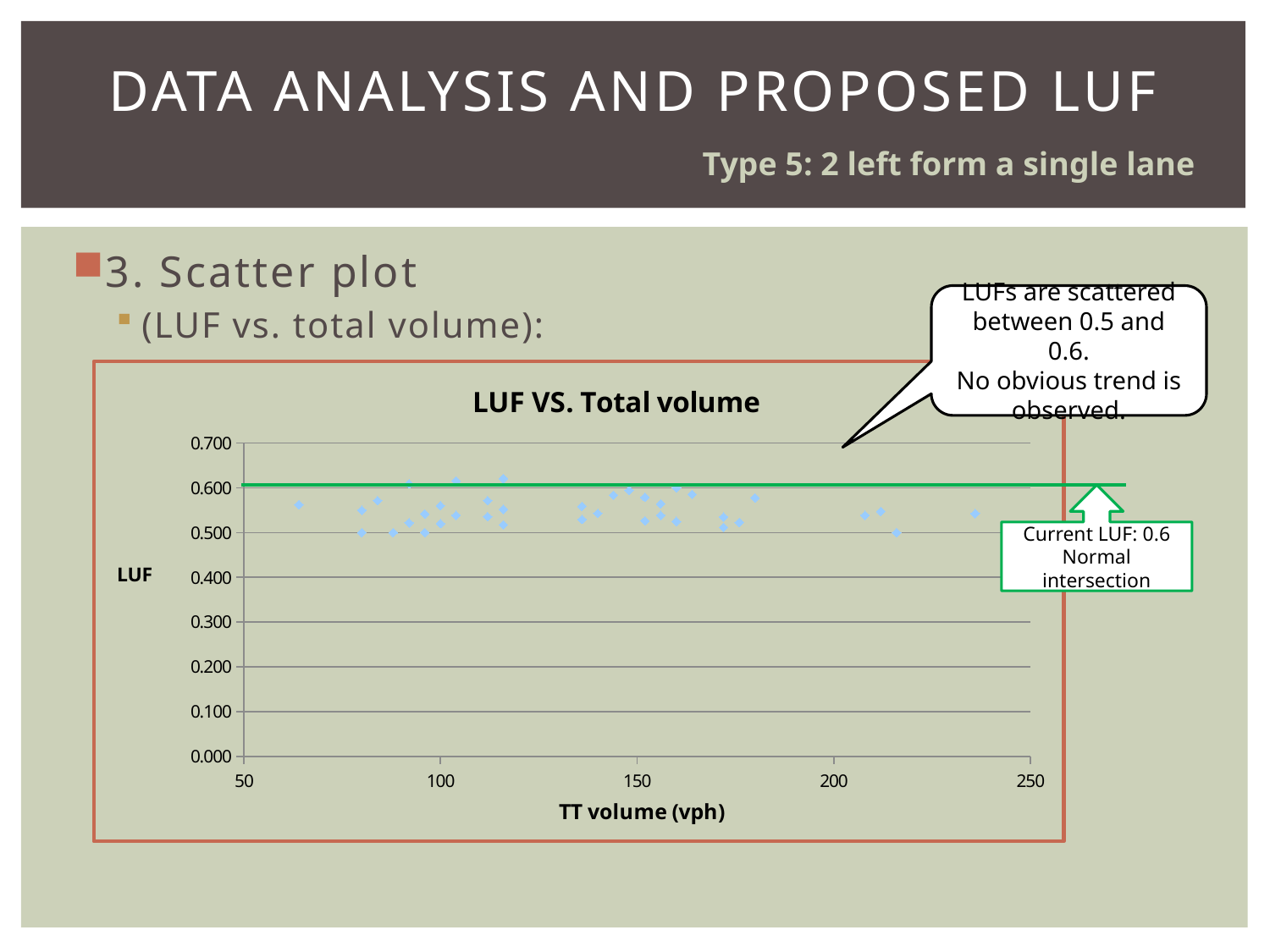
What is the highest value shown on the y axis of the chart? 0.700 Are the plotted LUF values greater or less than 0.300? greater Is there an obvious rising or falling trend in LUF as TT volume increases? No obvious trend What is the lowest TT volume value shown on the x axis? 50 Between which two LUF values are the data points scattered, according to the callout? 0.5 and 0.6 Are the plotted LUF values greater or less than 0.400? greater Are the plotted LUF values greater or less than 0.700? less What is the title of the chart? LUF VS. Total volume What is the highest TT volume value shown on the x axis? 250 What LUF value does the horizontal green line on the chart represent? 0.6 What kind of chart is shown on the slide? Scatter plot What is the label of the x axis of the chart? TT volume (vph)